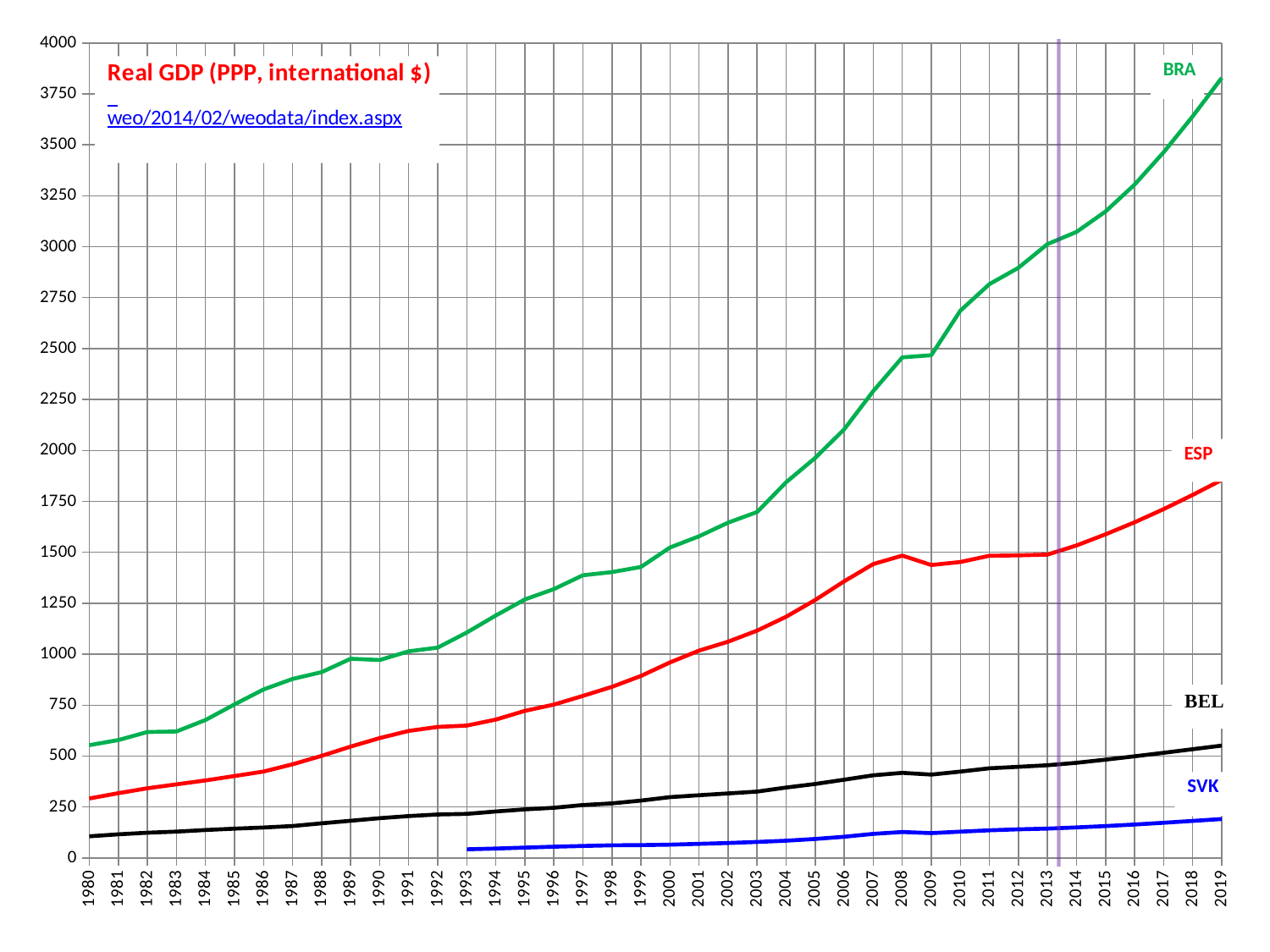
Which country has the highest Real GDP value in 2019? BRA Which series starts in 1993 rather than 1980? SVK Does the BRA line rise or fall overall from 1980 to 2019? rise Which is larger in 2019, the value for ESP or the value for BEL? ESP Which country has the lowest Real GDP value in 2019? SVK What kind of chart is shown on the slide? line chart How many years are shown along the x axis of the chart? 40 What is the title of the chart? Real GDP (PPP, international $) Is the value for BRA in 2019 greater or less than 3500? greater Is the value for ESP in 2003 greater or less than 1000? greater How many series (countries) are plotted on the chart? 4 Is the value for SVK in 2019 greater or less than 250? less